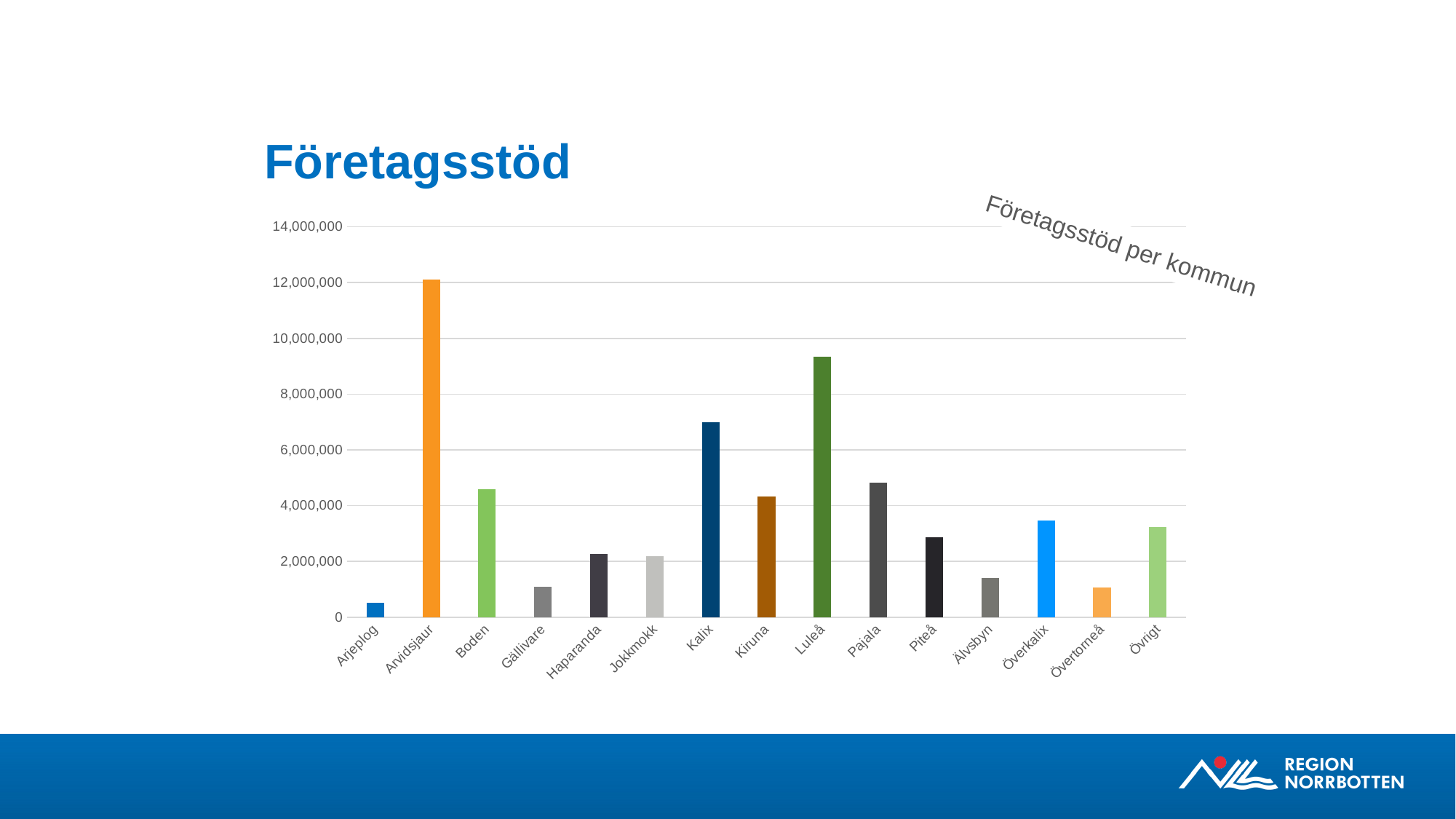
Is the value for Överkalix greater or less than 4,000,000? less Which municipality has the highest value in the chart? Arvidsjaur Which has a larger value, Piteå or Älvsbyn? Piteå Is the value for Piteå greater or less than 2,000,000? greater Which municipality has the lowest value in the chart? Arjeplog How many categories are shown on the x axis of the chart? 15 Which has a larger value, Kalix or Luleå? Luleå What is the title of the chart? Företagsstöd per kommun Is the value for Luleå greater or less than 8,000,000? greater What kind of chart is shown on the slide? Bar chart